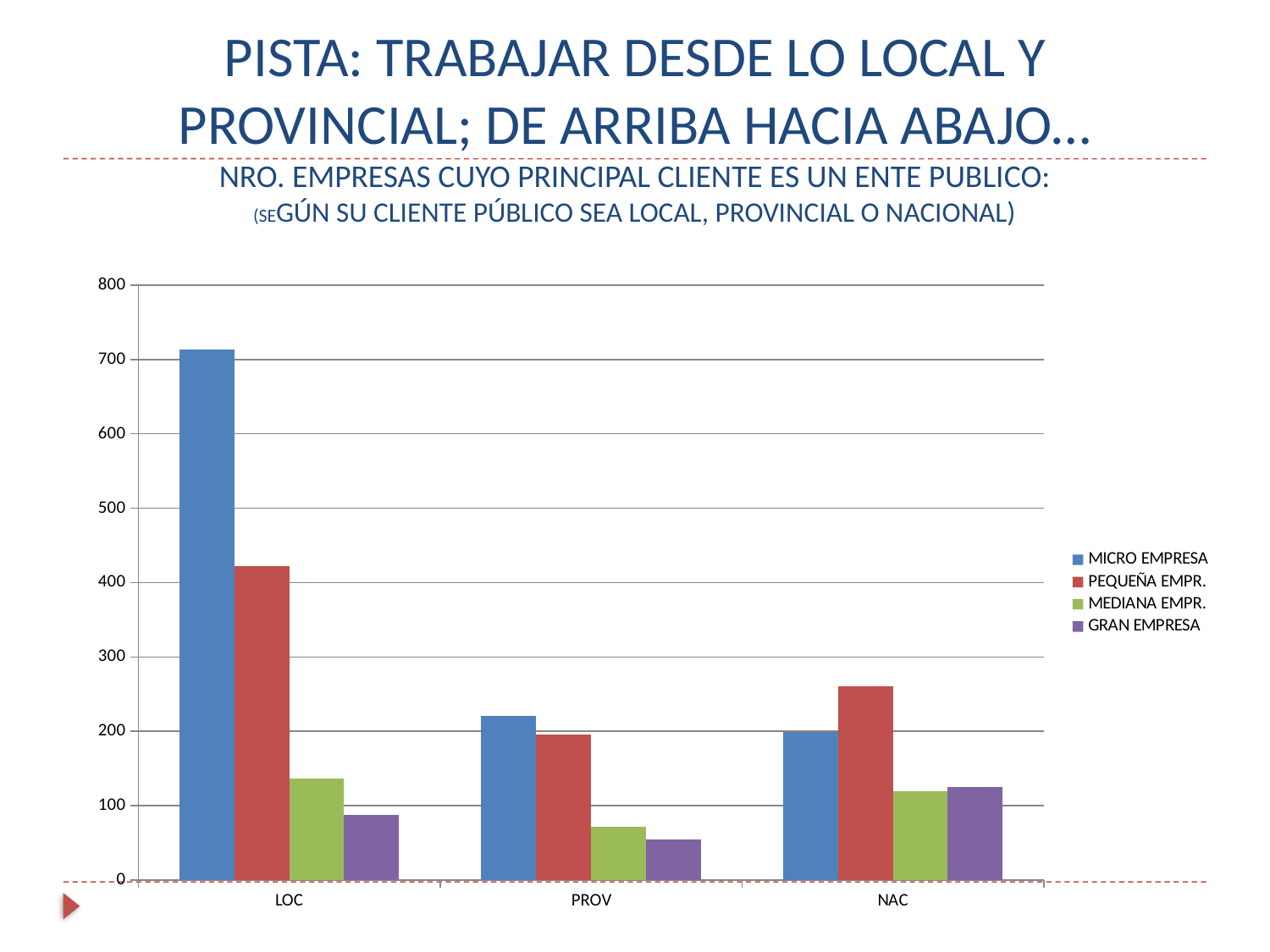
Which category has the highest MICRO EMPRESA value? LOC Is the MEDIANA EMPR. value for PROV greater or less than 100? less What kind of chart is shown on the slide? bar chart How many series does the legend list? 4 For LOC, which is larger: MEDIANA EMPR. or GRAN EMPRESA? MEDIANA EMPR. For NAC, which is larger: MICRO EMPRESA or PEQUEÑA EMPR.? PEQUEÑA EMPR. How many categories are shown on the x axis? 3 Is the PEQUEÑA EMPR. value for LOC greater or less than 400? greater Which category has the lowest GRAN EMPRESA value? PROV Is the MICRO EMPRESA value for LOC greater or less than 700? greater Which colour represents GRAN EMPRESA in the legend? purple